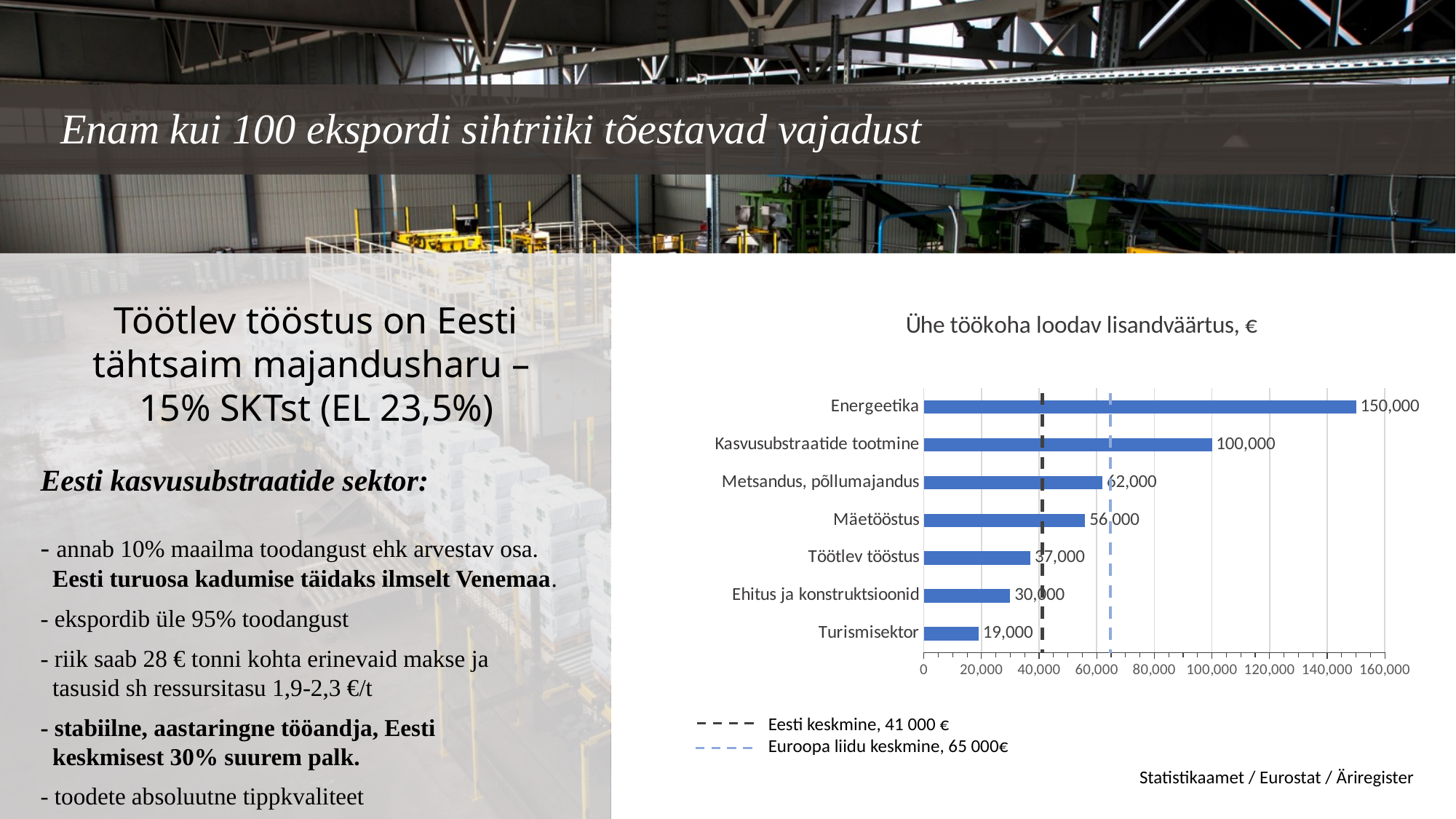
What is the value for Kasvusubstraatide tootmine? 100,000 What is the value for Energeetika? 150,000 What type of chart is shown on the slide? bar chart What is the value for Turismisektor? 19,000 How many categories are plotted in the chart? 7 Which category has the lowest value? Turismisektor What is the title of the chart on the slide? Ühe töökoha loodav lisandväärtus, € What is the value for Töötlev tööstus? 37,000 Which is larger, the value for Mäetööstus or the value for Metsandus, põllumajandus? Metsandus, põllumajandus What is the difference between the values for Energeetika and Kasvusubstraatide tootmine? 50,000 Which category has the highest value? Energeetika According to the legend, what is the Eesti keskmine value marked by the dark dashed line? 41 000 €